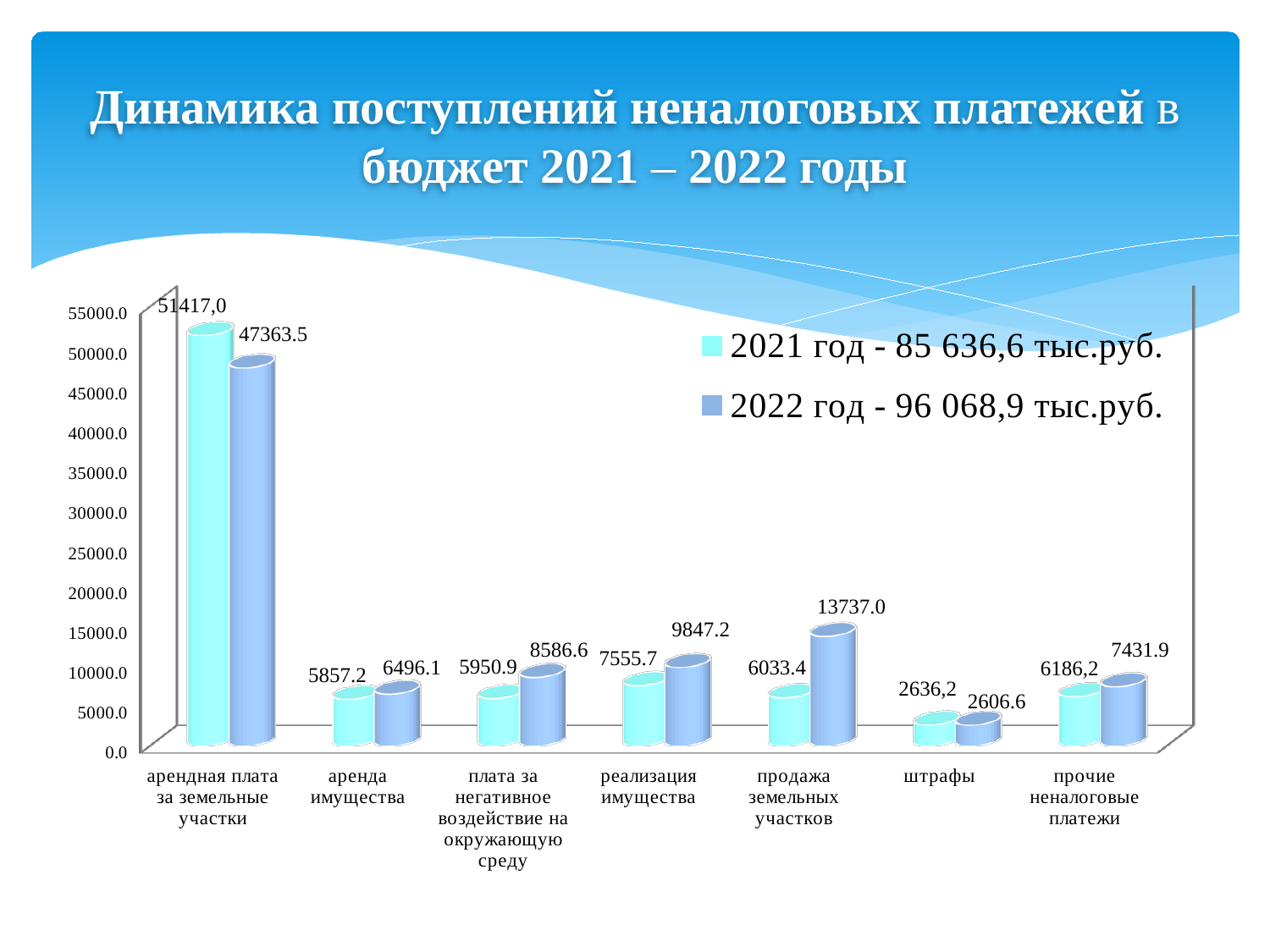
Which is larger for арендная плата за земельные участки: the 2021 value or the 2022 value? 2021 What is the 2021 value for арендная плата за земельные участки? 51417,0 How many series does the legend list? 2 What is the difference between the 2022 and 2021 values for продажа земельных участков? 7703.6 Which category has the lowest 2021 value? штрафы How many categories are shown on the x axis? 7 What is the difference between the 2022 and 2021 values for реализация имущества? 2291.5 What is the 2021 value for штрафы? 2636,2 What is the 2022 value for плата за негативное воздействие на окружающую среду? 8586.6 What type of chart is shown on the slide? bar chart Which category has the highest 2022 value? арендная плата за земельные участки What is the 2022 value for продажа земельных участков? 13737.0